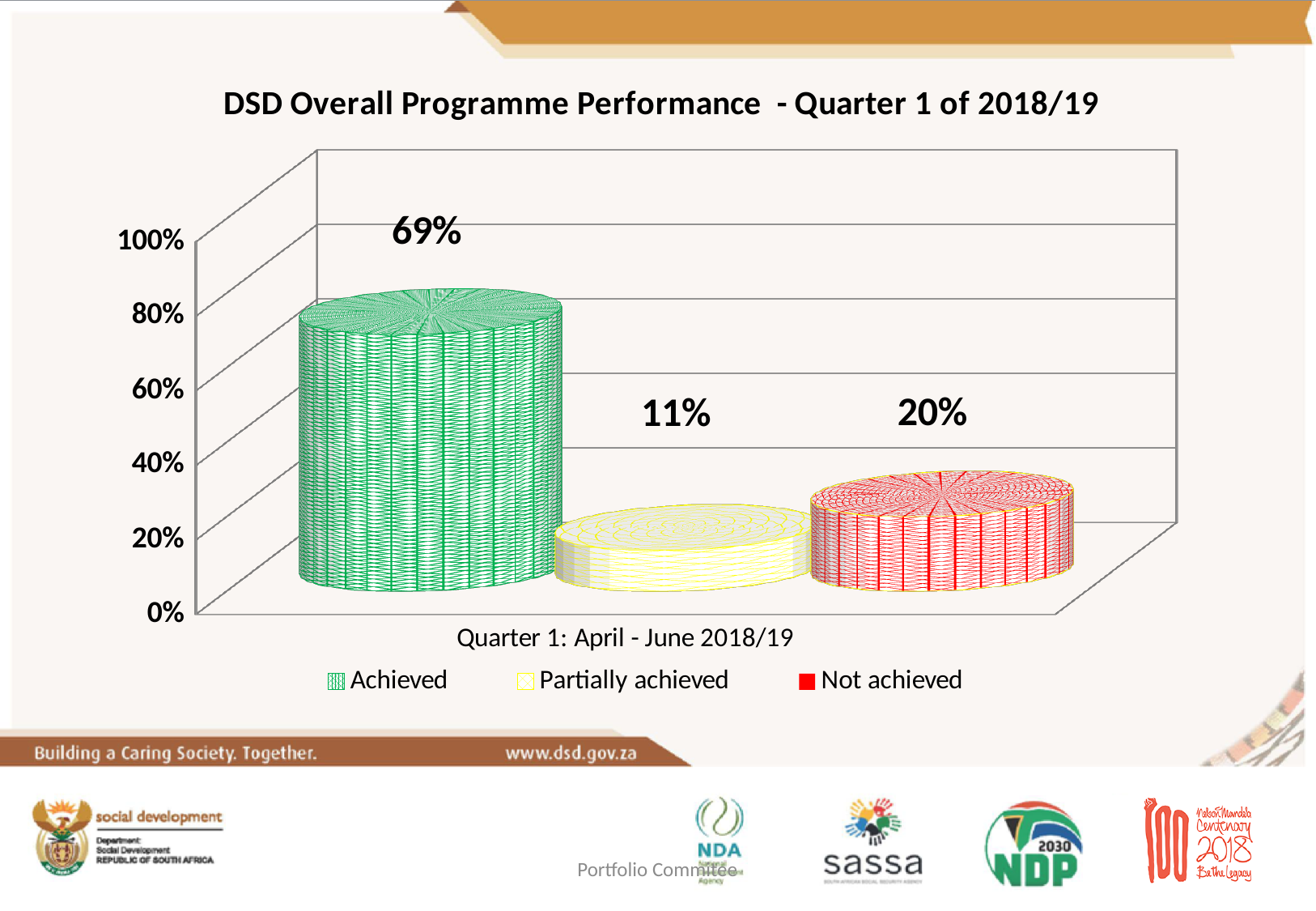
What percentage of targets were Not achieved in Quarter 1 of 2018/19? 20% What percentage of targets were Achieved in Quarter 1 of 2018/19? 69% Which series has the highest value in the chart? Achieved Which series has the lowest value in the chart? Partially achieved What is the difference between the Achieved and Not achieved percentages? 49% What kind of chart is shown on the slide? Bar chart Which is larger, the Not achieved value or the Partially achieved value? Not achieved How many series does the legend list? 3 What is the difference between the Not achieved and Partially achieved percentages? 9% What percentage of targets were Partially achieved in Quarter 1 of 2018/19? 11% Is the value for Achieved greater or less than 60%? greater What is the title of the chart? DSD Overall Programme Performance - Quarter 1 of 2018/19